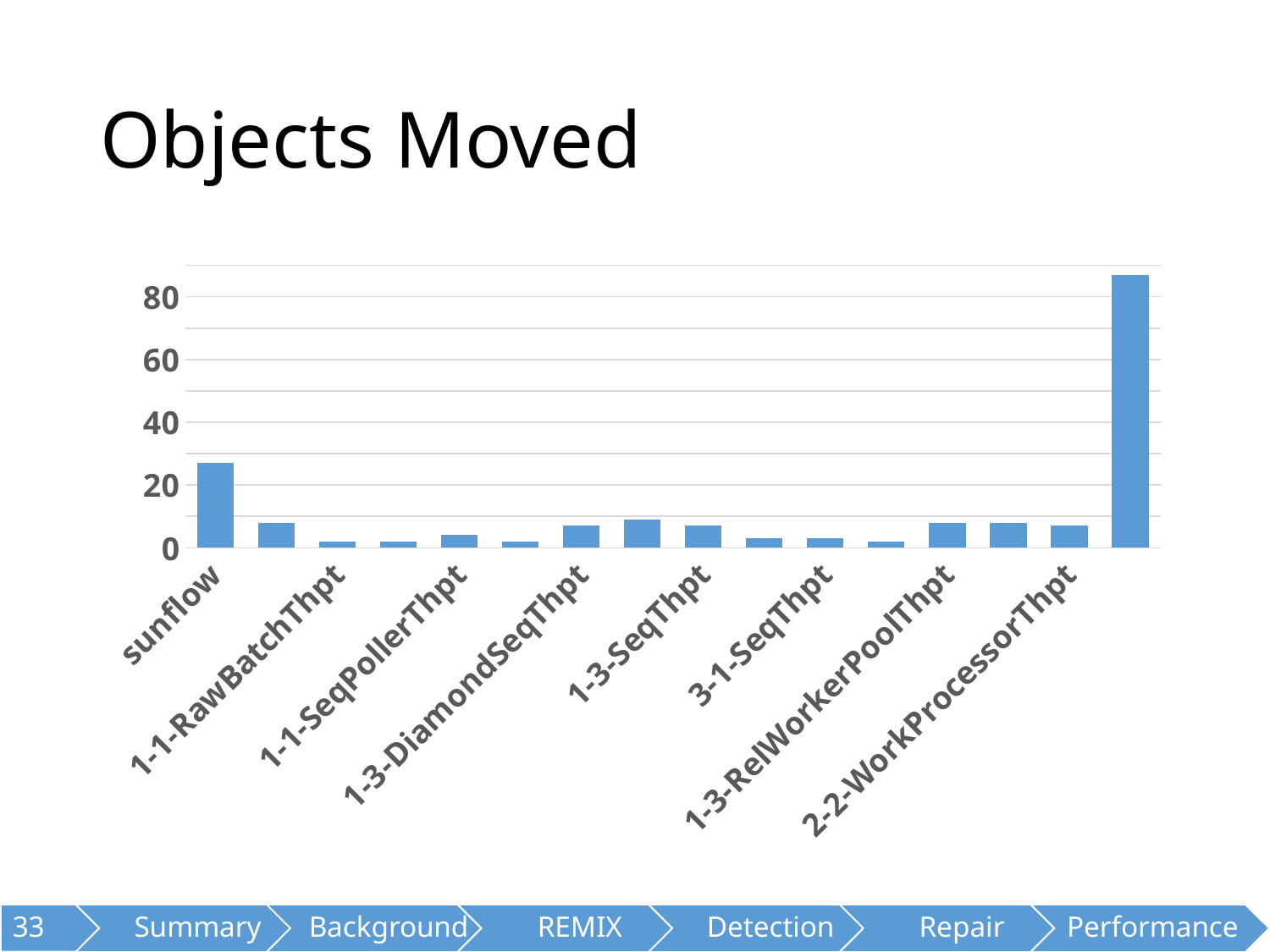
Is the value for sunflow greater or less than 40? less What is the highest value labelled on the vertical axis? 80 Is the value for sunflow greater or less than 20? greater Is the value for 1-1-RawBatchThpt greater or less than 20? less Which is larger, the value for sunflow or the value for 3-1-SeqThpt? sunflow How many bars are plotted in the chart? 16 What kind of chart is shown on the slide? bar chart Which is larger, the value for sunflow or the value for 1-1-RawBatchThpt? sunflow Which is larger, the value for 1-3-SeqThpt or the value for 1-1-SeqPollerThpt? 1-3-SeqThpt What is the title of the chart? Objects Moved